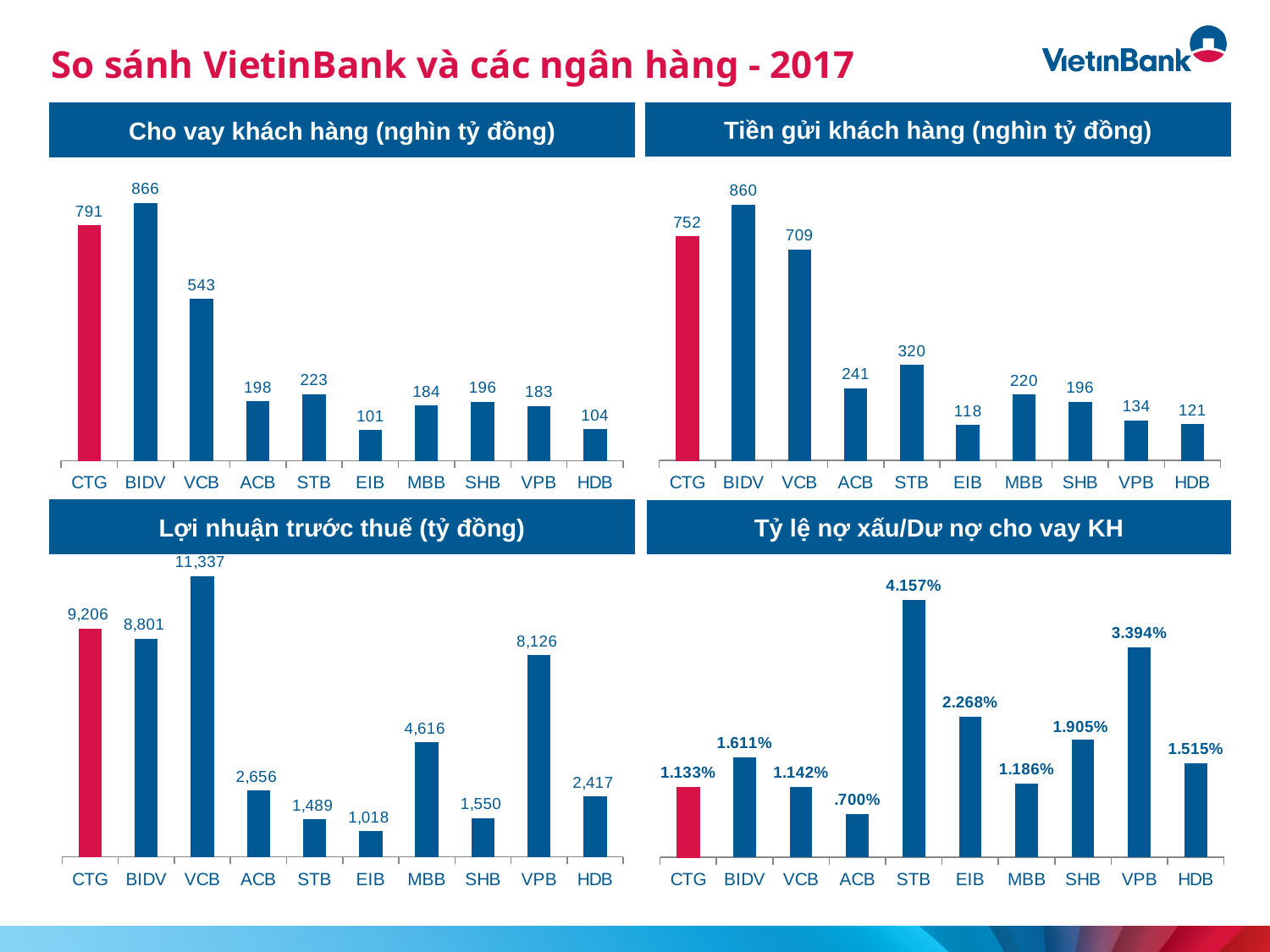
In the chart titled "Lợi nhuận trước thuế (tỷ đồng)", which is larger, CTG or BIDV? CTG In the chart titled "Tỷ lệ nợ xấu/Dư nợ cho vay KH", which bank has the lowest value? ACB In the chart titled "Cho vay khách hàng (nghìn tỷ đồng)", which bank has the lowest value? EIB In the chart titled "Tỷ lệ nợ xấu/Dư nợ cho vay KH", what is the value for STB? 4.157% In the chart titled "Cho vay khách hàng (nghìn tỷ đồng)", what is the value for CTG? 791 In the chart titled "Tiền gửi khách hàng (nghìn tỷ đồng)", how many banks are shown? 10 In the chart titled "Lợi nhuận trước thuế (tỷ đồng)", which bank has the highest value? VCB What type of chart is the chart titled "Tỷ lệ nợ xấu/Dư nợ cho vay KH"? Bar chart In the chart titled "Lợi nhuận trước thuế (tỷ đồng)", what is the value for VPB? 8,126 In the chart titled "Tiền gửi khách hàng (nghìn tỷ đồng)", what is the value for VCB? 709 In the chart titled "Tiền gửi khách hàng (nghìn tỷ đồng)", what is the difference between BIDV and CTG? 108 In the chart titled "Cho vay khách hàng (nghìn tỷ đồng)", which bank has the highest value? BIDV